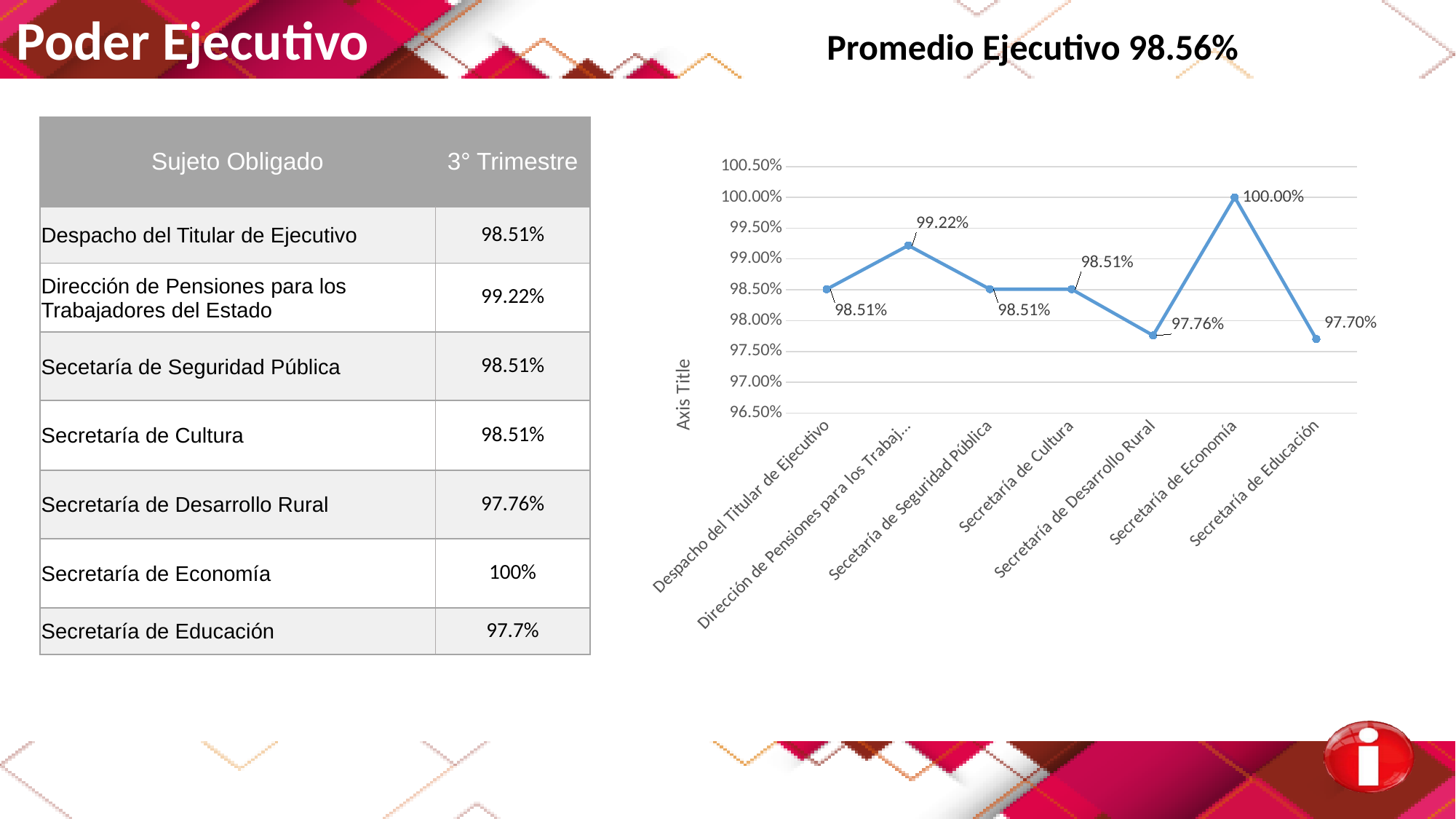
Which is larger in the chart: the value for Secretaría de Seguridad Pública or the value for Secretaría de Desarrollo Rural? Secretaría de Seguridad Pública What is the value plotted for Secretaría de Educación in the chart? 97.70% Which category has the lowest value in the chart? Secretaría de Educación Is the value for Secretaría de Educación in the chart greater or less than 98.00%? less What is the difference between the values for Secretaría de Economía and Secretaría de Desarrollo Rural in the chart? 2.24% What kind of chart is shown on the slide? line chart What is the title shown on the vertical axis of the chart? Axis Title Which category has the highest value in the chart? Secretaría de Economía What is the value plotted for Secretaría de Economía in the chart? 100.00% What is the value plotted for Secretaría de Cultura in the chart? 98.51% How many categories are plotted on the x axis of the chart? 7 What is the value plotted for Secretaría de Desarrollo Rural in the chart? 97.76%